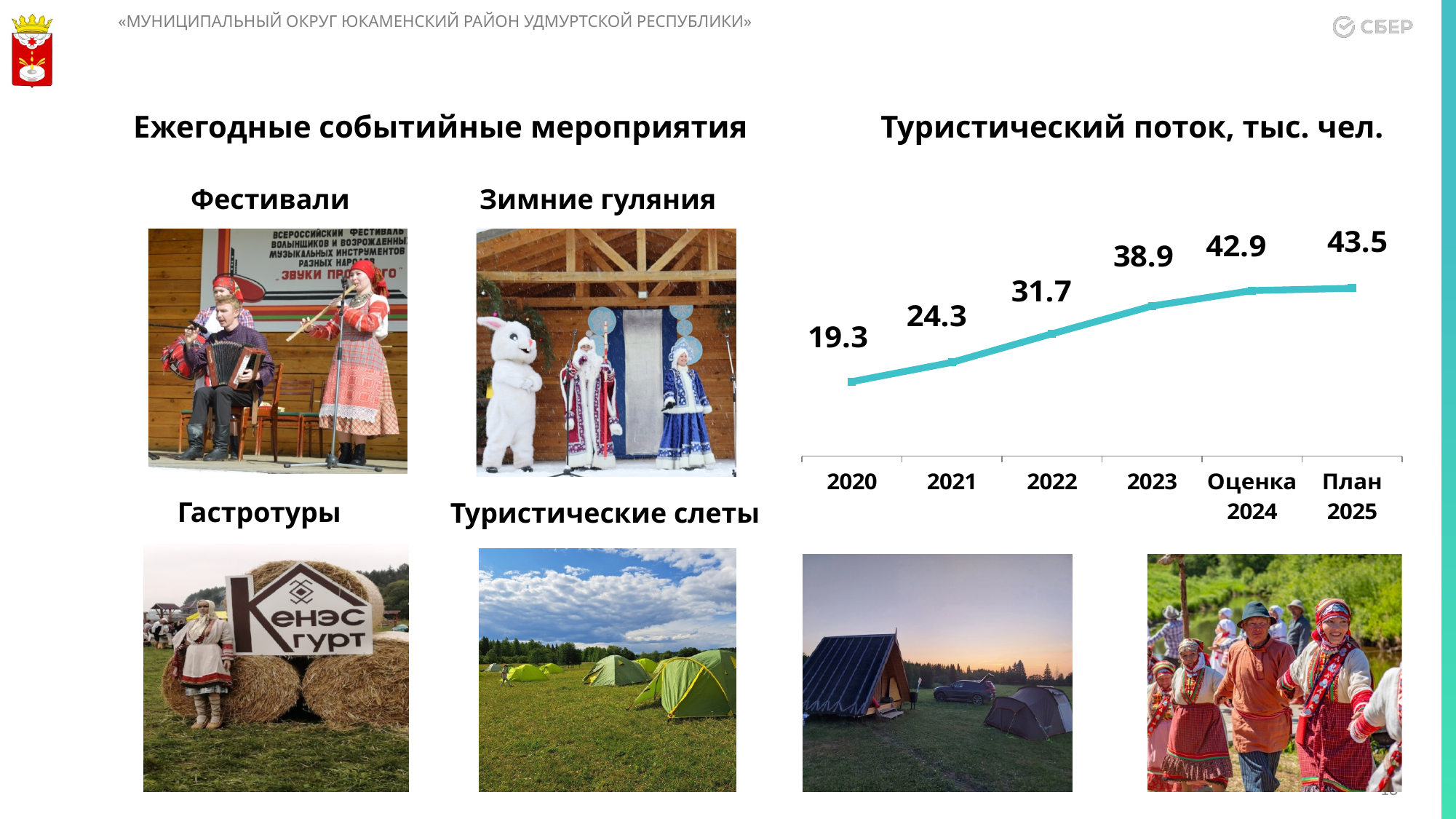
How many data points are plotted on the chart? 6 Which point on the chart has the lowest value? 2020 What type of chart is used to show the tourist flow? Line chart What is the difference between the values for 2023 and 2022? 7.2 What is the tourist flow value for 2022? 31.7 What is the value shown for План 2025? 43.5 Which is larger, the value for 2021 or the value for 2023? 2023 Do the values rise or fall from 2020 to План 2025? Rise What is the tourist flow value for 2020? 19.3 Which point on the chart has the highest value? План 2025 What is the value shown for Оценка 2024? 42.9 What is the difference between the values for План 2025 and 2020? 24.2